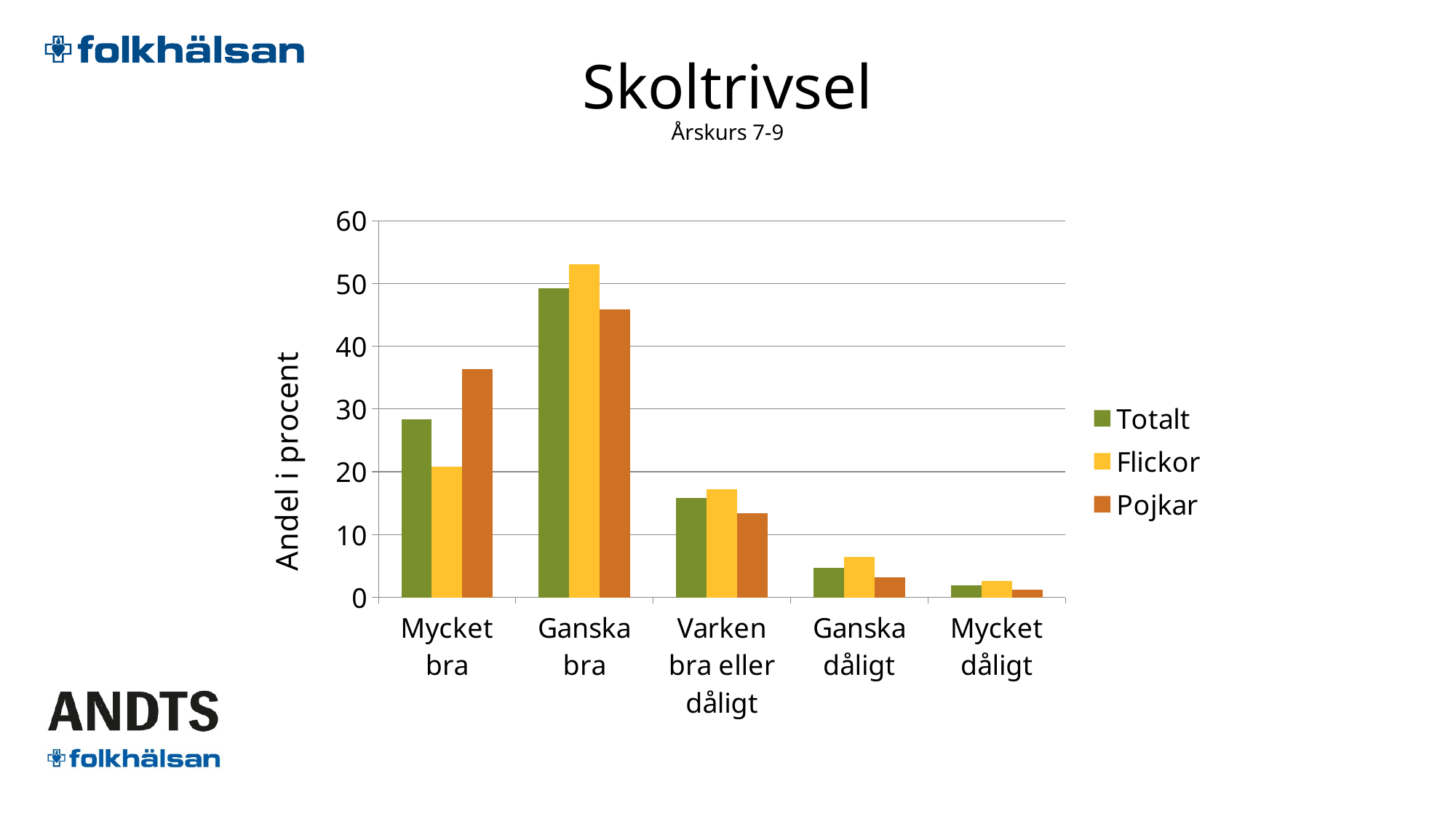
For the Flickor series, which category has the highest value? Ganska bra For the Pojkar series, which category has the lowest value? Mycket dåligt In the Ganska bra category, which is larger: Flickor or Pojkar? Flickor What is the title of the y axis? Andel i procent What are the three series listed in the legend? Totalt, Flickor, Pojkar How many series does the legend list? 3 What kind of chart is shown on the slide? bar chart Is the Pojkar value for Mycket bra greater or less than 30? greater How many categories are shown on the x axis of the chart? 5 Is the Totalt value for Varken bra eller dåligt greater or less than 20? less Is the Flickor value for Ganska bra greater or less than 50? greater In the Mycket bra category, which is larger: Flickor or Pojkar? Pojkar